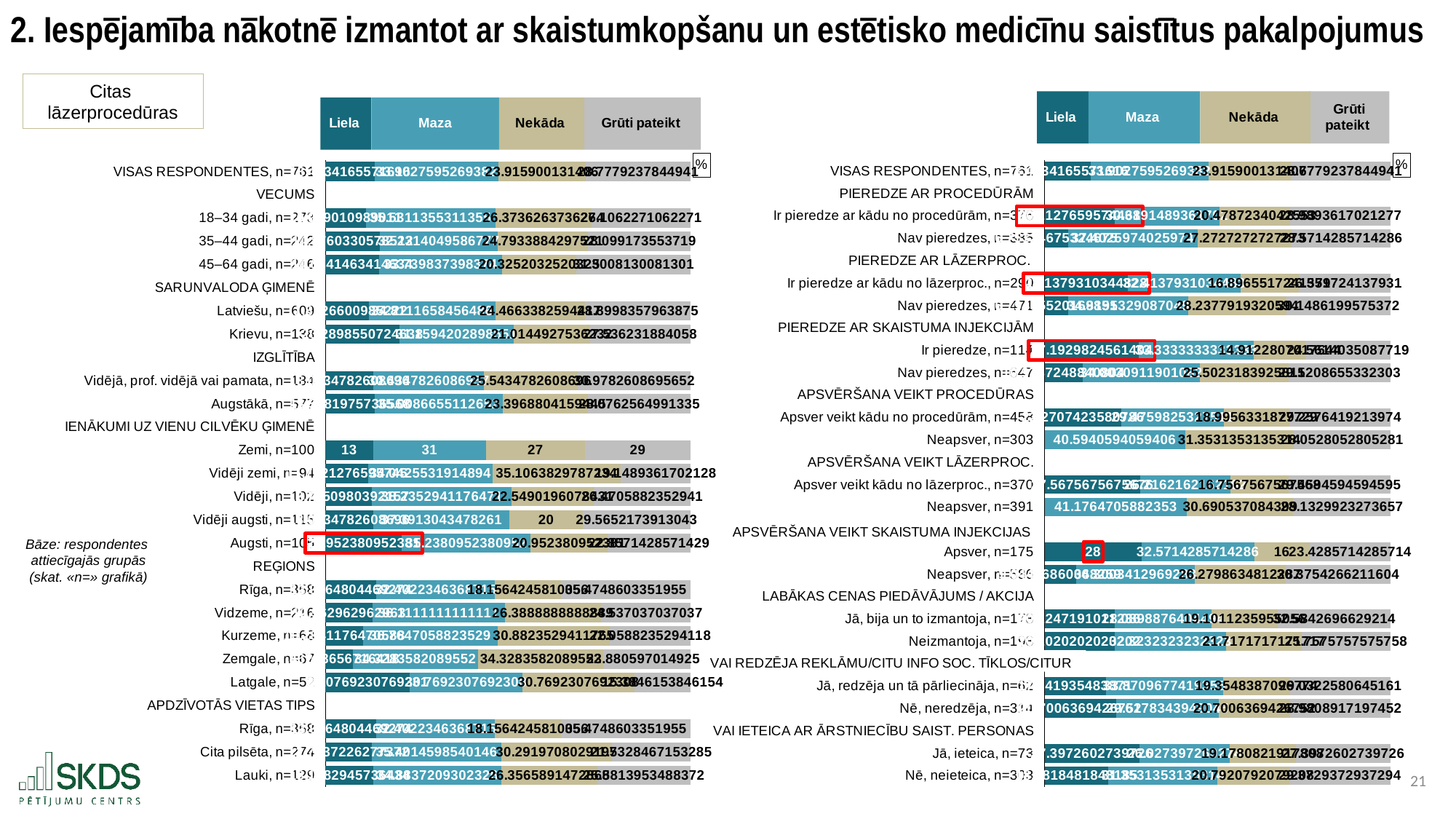
In the left chart, what is the difference between the 'Maza' and 'Liela' values for 'Zemi, n=100'? 18 In the right chart, for 'Apsver, n=175', which is larger: 'Liela' or 'Maza'? Maza How many series does the legend of the left chart list? 4 In the left chart, what is the 'Maza' value for 'Zemi, n=100'? 31 In the left chart, what is the total of the 'Zemi, n=100' stacked bar? 100 In the right chart, what is the 'Liela' value for 'Apsver, n=175'? 28 In the left chart, what is the 'Liela' value for 'Zemi, n=100'? 13 In the left chart, which series has the lowest value in the 'Zemi, n=100' bar? Liela In the left chart, what is the 'Grūti pateikt' value for 'Zemi, n=100'? 29 In the left chart, what is the 'Nekāda' value for 'Zemi, n=100'? 27 What kind of chart is used on this slide? stacked bar chart In the left chart, which series has the highest value in the 'Zemi, n=100' bar? Maza